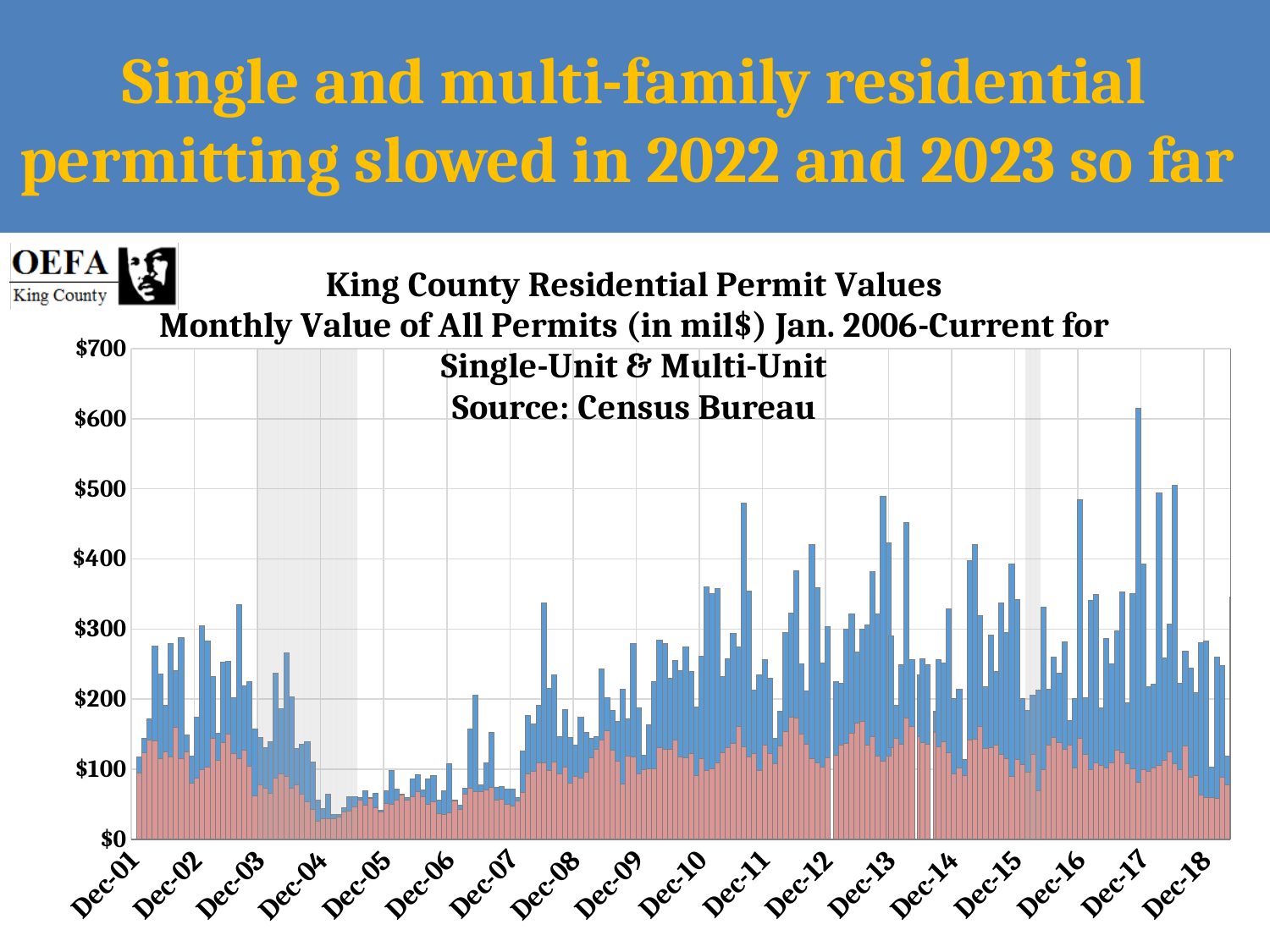
Do the bar values rise or fall between Dec-03 and Dec-04? fall What is the highest value shown on the y axis? $700 Are the bars around Dec-04 greater or less than $100? less What is the title of the chart? King County Residential Permit Values Is the tallest bar on the chart greater or less than $600? greater Is the first bar at Dec-01 greater or less than $200? less Is the tallest bar near Dec-17 larger or smaller than the tallest bar near Dec-04? larger How many year labels (Dec-01 through Dec-18) are shown on the x axis? 18 What source is cited for the chart's data? Census Bureau What kind of chart is shown on the slide? bar chart What unit are the permit values expressed in, according to the chart title? mil$ Near which x-axis label does the tallest bar on the chart appear? Dec-17